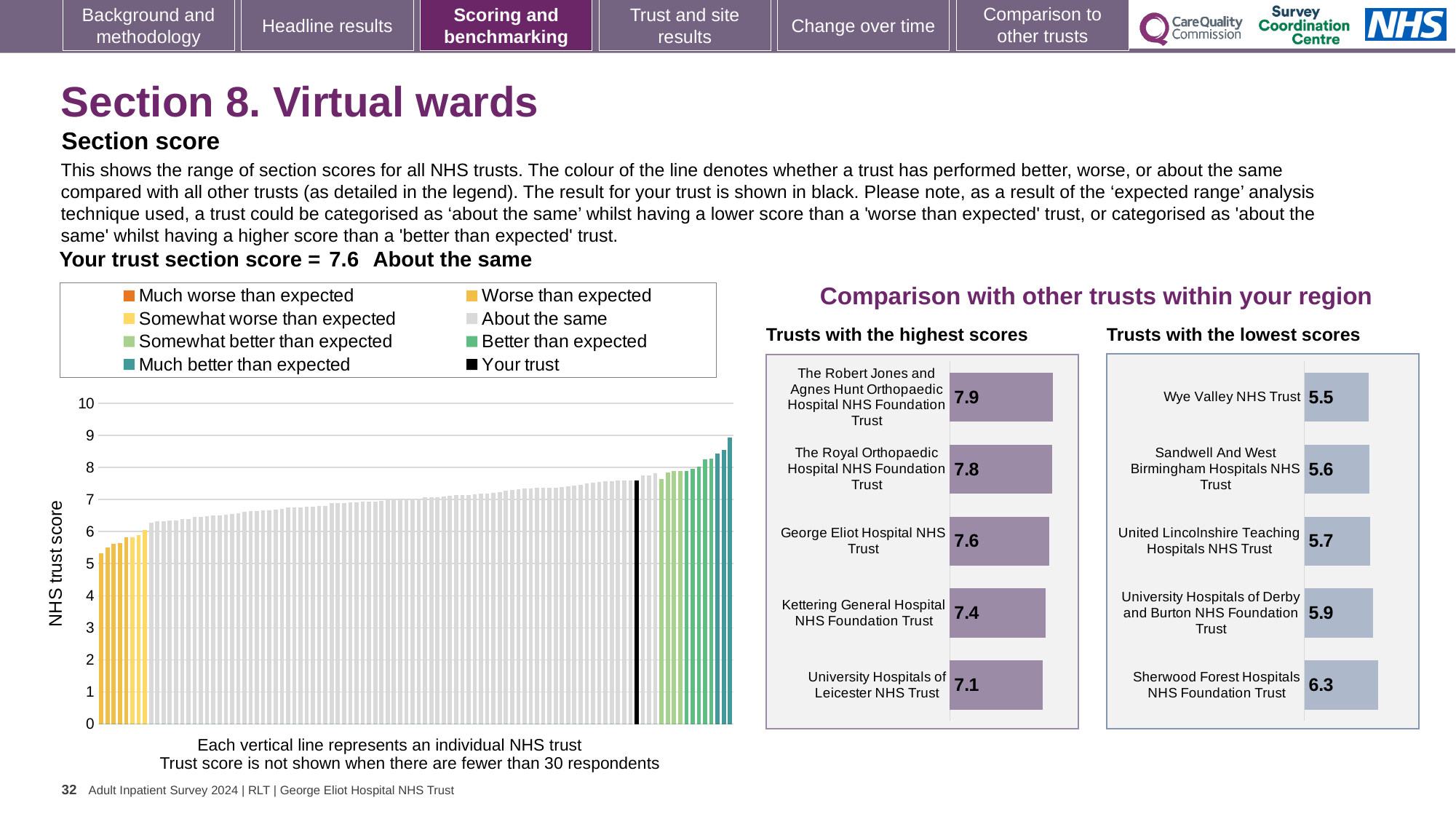
How many trusts are shown in the 'Trusts with the lowest scores' chart? 5 In the 'Trusts with the lowest scores' chart, what is the score for Wye Valley NHS Trust? 5.5 In the 'Trusts with the highest scores' chart, what is the difference between the scores of The Robert Jones and Agnes Hunt Orthopaedic Hospital NHS Foundation Trust and University Hospitals of Leicester NHS Trust? 0.8 In the 'Trusts with the highest scores' chart, what is the score for Kettering General Hospital NHS Foundation Trust? 7.4 In the 'Trusts with the highest scores' chart, what is the score for The Robert Jones and Agnes Hunt Orthopaedic Hospital NHS Foundation Trust? 7.9 In the 'Trusts with the highest scores' chart, which trust has the lowest score? University Hospitals of Leicester NHS Trust In the 'Trusts with the lowest scores' chart, which trust has the highest score? Sherwood Forest Hospitals NHS Foundation Trust In the large chart on the left, do the bar values rise or fall from left to right? rise What kind of chart is the large chart on the left showing NHS trust scores? bar chart In the large chart on the left, is the value of the tallest bar greater or less than 8? greater In the 'Trusts with the lowest scores' chart, which has the larger score: United Lincolnshire Teaching Hospitals NHS Trust or University Hospitals of Derby and Burton NHS Foundation Trust? University Hospitals of Derby and Burton NHS Foundation Trust How many entries does the legend of the large chart on the left list? 8